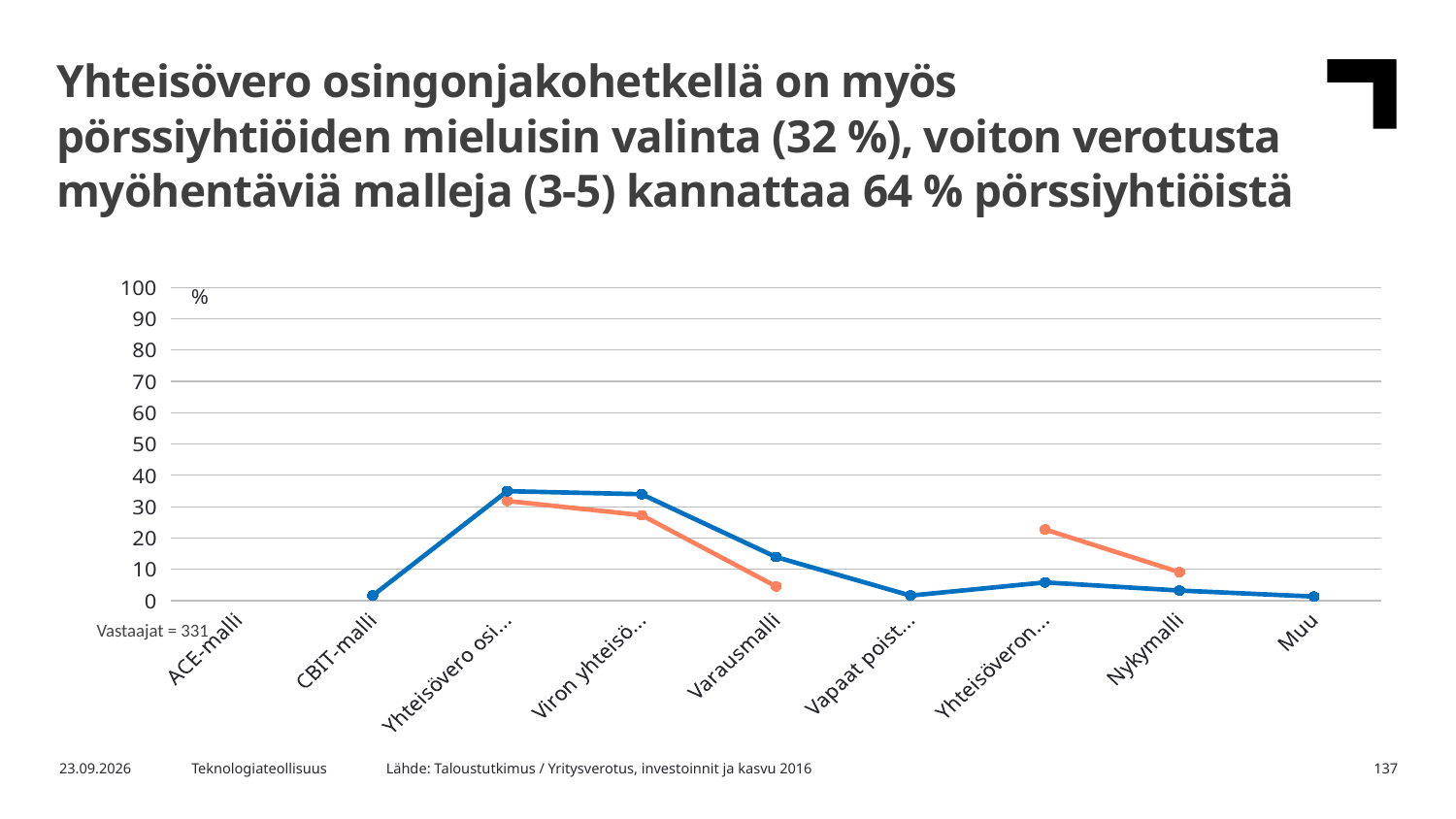
At 'Varausmalli', which line has the larger value, the blue or the orange? blue Is the value of the orange line for 'Varausmalli' greater or less than 10? less What kind of chart is shown on the slide? line chart How many lines (series) are plotted in the chart? 2 Does the blue line rise or fall from 'Viron yhteisö...' to 'Vapaat poist...'? fall Is the value of the blue line for 'Varausmalli' greater or less than 10? greater Is the value of the orange line for 'Yhteisöveron...' greater or less than 20? greater At 'Yhteisöveron...', which line has the larger value, the blue or the orange? orange For which category does the orange line reach its highest value? Yhteisövero osi... How many categories are shown on the x axis of the chart? 9